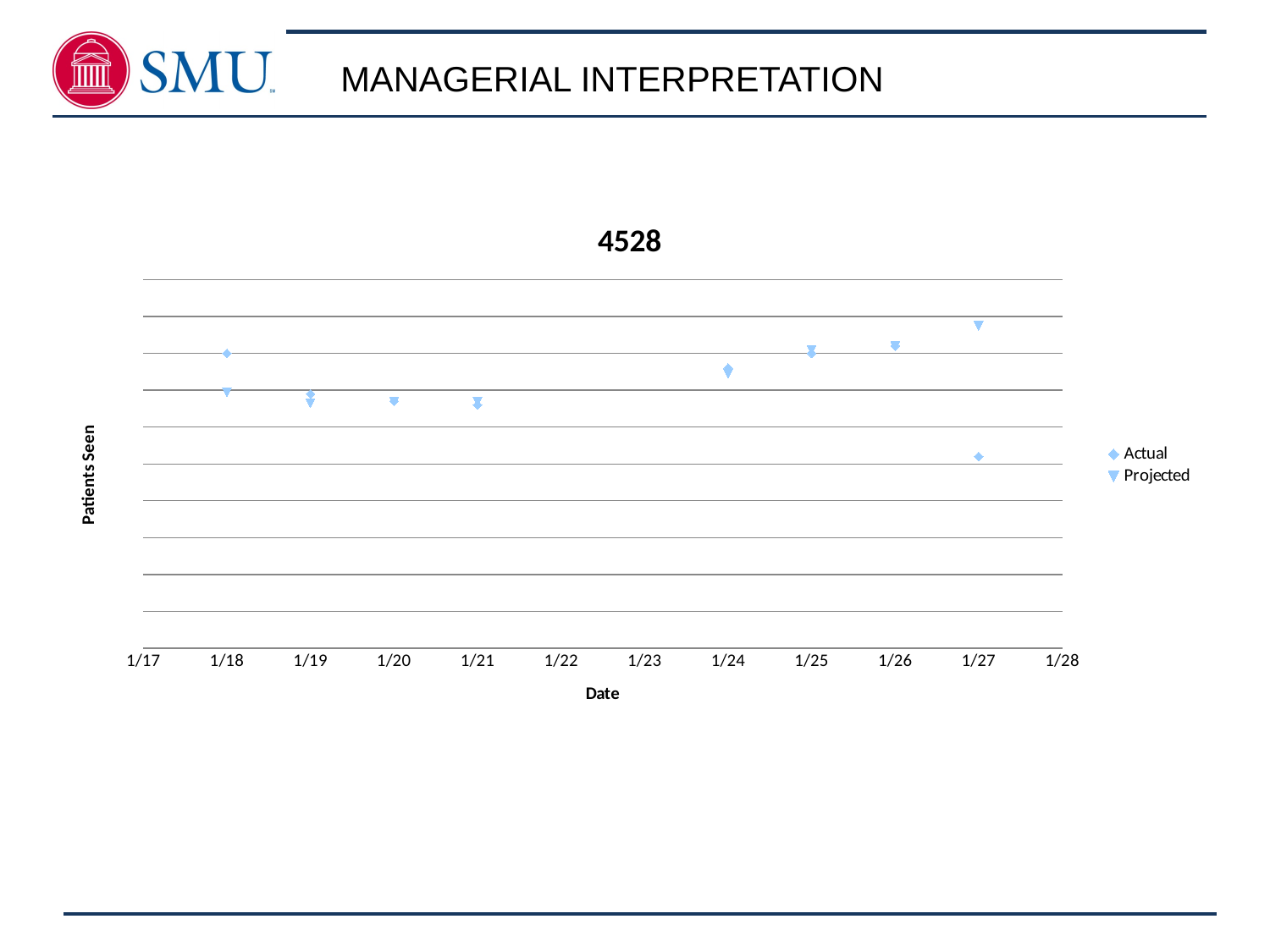
On 1/18, which is higher: the Actual value or the Projected value? Actual On which date is the Projected value highest? 1/27 What is the title of the chart? 4528 What are the two series named in the legend? Actual and Projected What kind of chart is shown on the slide? Scatter chart On 1/27, which is higher: the Actual value or the Projected value? Projected How many dates have data points plotted on the chart? 8 How many series does the legend list? 2 Do the Projected values rise or fall from 1/21 to 1/27? Rise Do the Projected values rise or fall from 1/18 to 1/21? Fall On which date is the Actual value lowest? 1/27